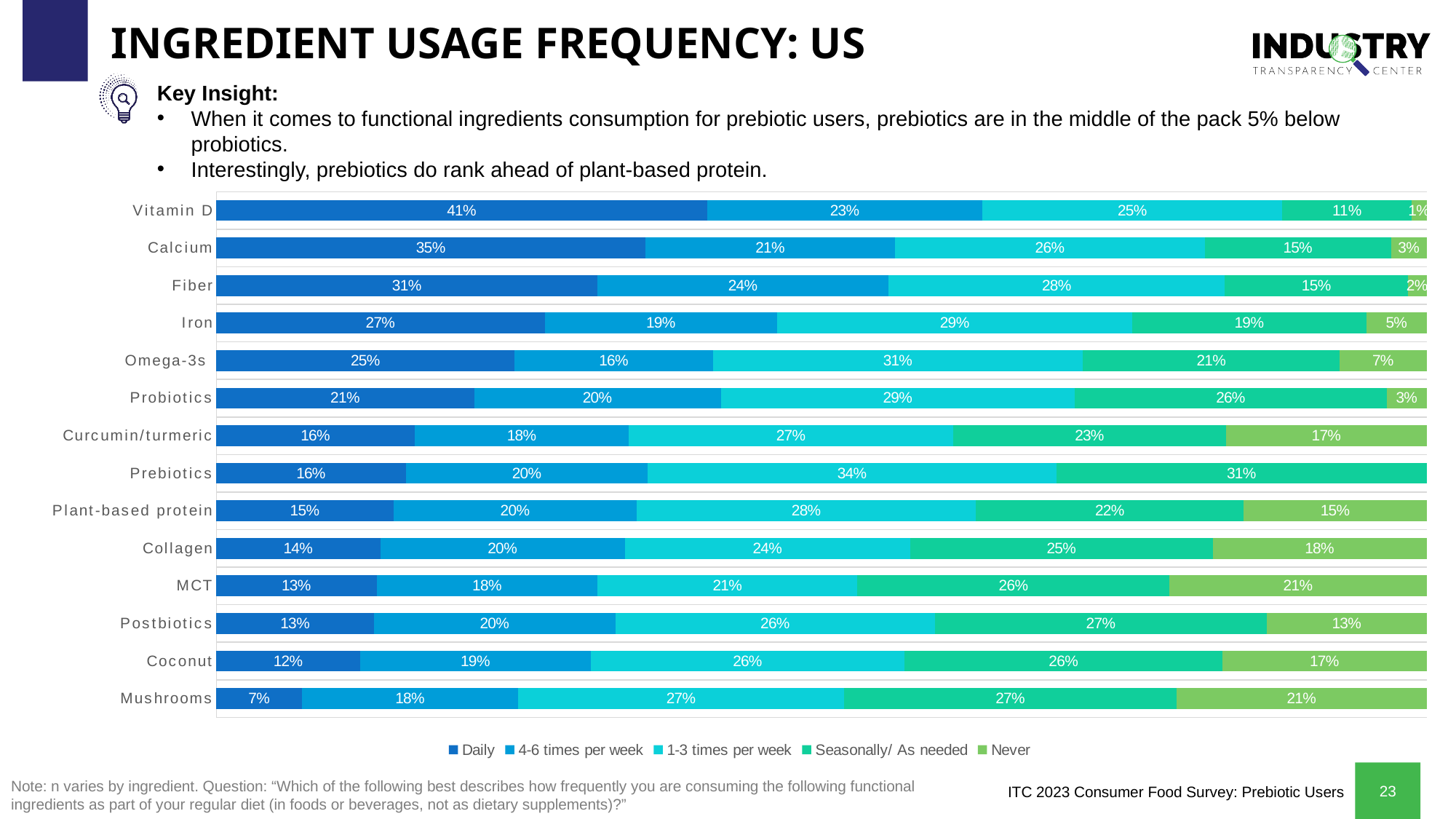
What is the 'Never' value for MCT? 21% What is the '1-3 times per week' value for Prebiotics? 34% What is the difference between the 'Daily' values for Probiotics and Prebiotics? 5% How many series does the legend list? 5 Which has a larger '1-3 times per week' value, Omega-3s or Iron? Omega-3s Which ingredient has the lowest 'Daily' value? Mushrooms What percentage of prebiotic users consume Vitamin D daily? 41% What kind of chart is shown on the slide? Stacked bar chart What is the 'Seasonally/ As needed' value for Probiotics? 26% Which has a larger 'Daily' value, Calcium or Fiber? Calcium Which ingredient has the highest 'Daily' value? Vitamin D How many ingredients are shown on the chart? 14